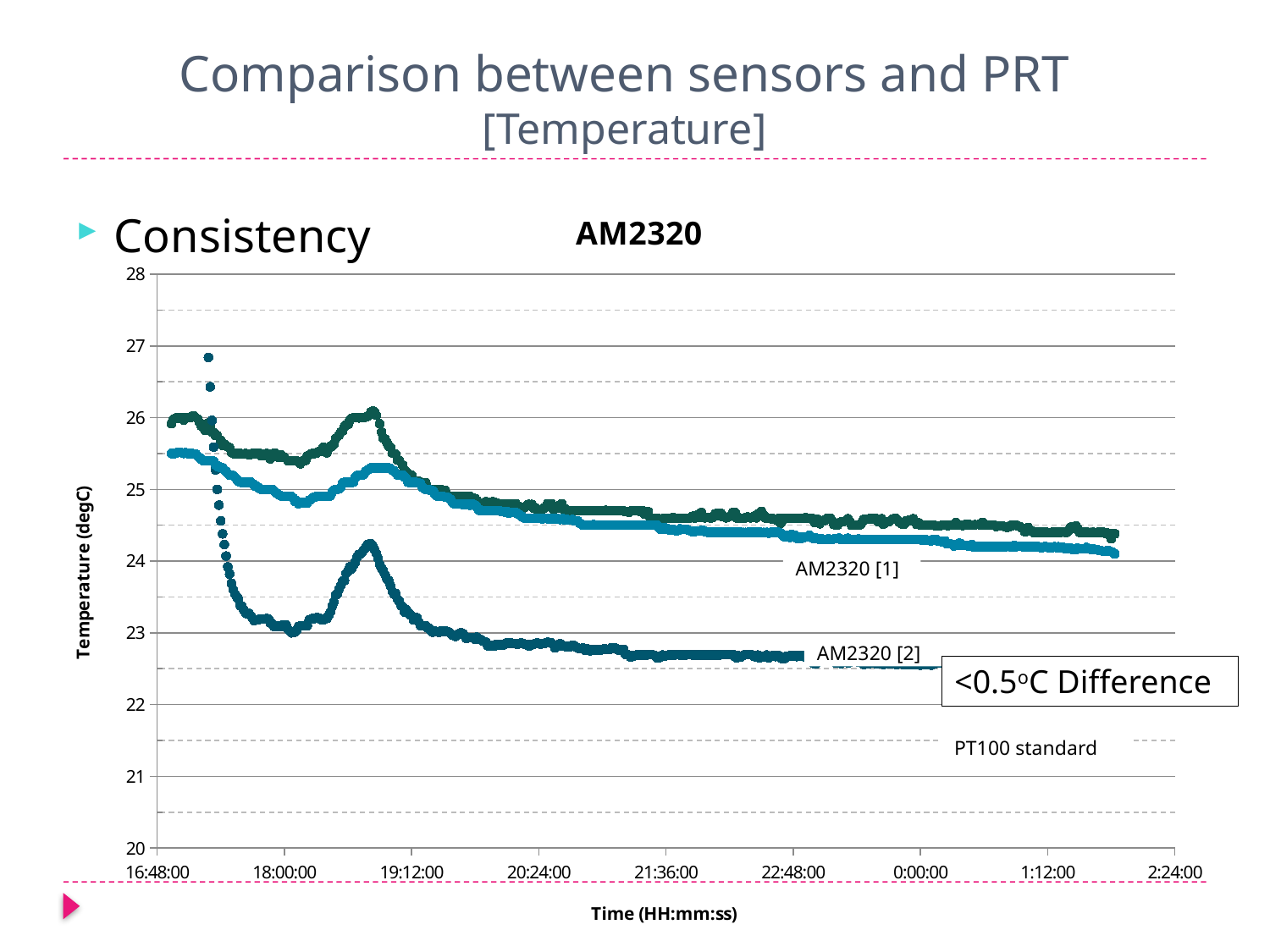
What is the title of the chart? AM2320 Is the highest temperature plotted on the chart greater or less than 27? less What are the names of the three series labelled on the chart? AM2320 [1], AM2320 [2], PT100 standard Is the lowest line on the chart at 22:48:00 greater or less than 22? greater What kind of chart is shown on the slide? Scatter (line) chart How many data series are labelled on the chart? 3 Is the lowest line on the chart at 22:48:00 greater or less than 23? less Do the plotted temperatures generally rise or fall over time along the x axis? Fall What is the maximum value shown on the y axis of the chart? 28 What is the first time shown on the x axis of the chart? 16:48:00